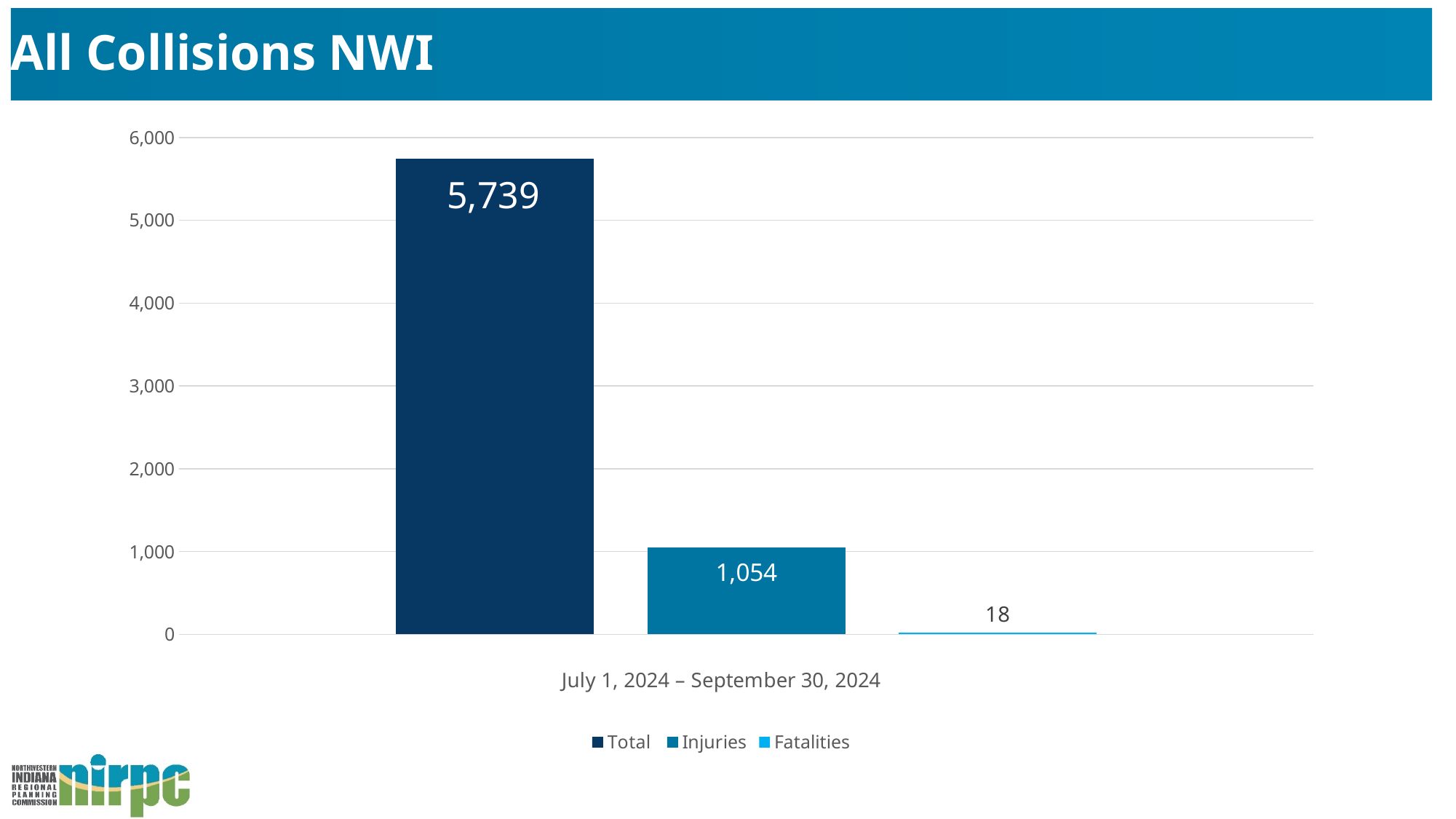
What is the difference between Injuries and Fatalities? 1,036 How many series does the legend list? 3 Which series has the highest value? Total What date range is shown on the x axis of the chart? July 1, 2024 – September 30, 2024 Which is larger, Injuries or Fatalities? Injuries Is the value for Total greater or less than 5,000? greater What kind of chart is shown on the slide? Bar chart What is the value for Total? 5,739 What is the value for Injuries? 1,054 Which series has the lowest value? Fatalities What is the difference between Total and Injuries? 4,685 What is the value for Fatalities? 18